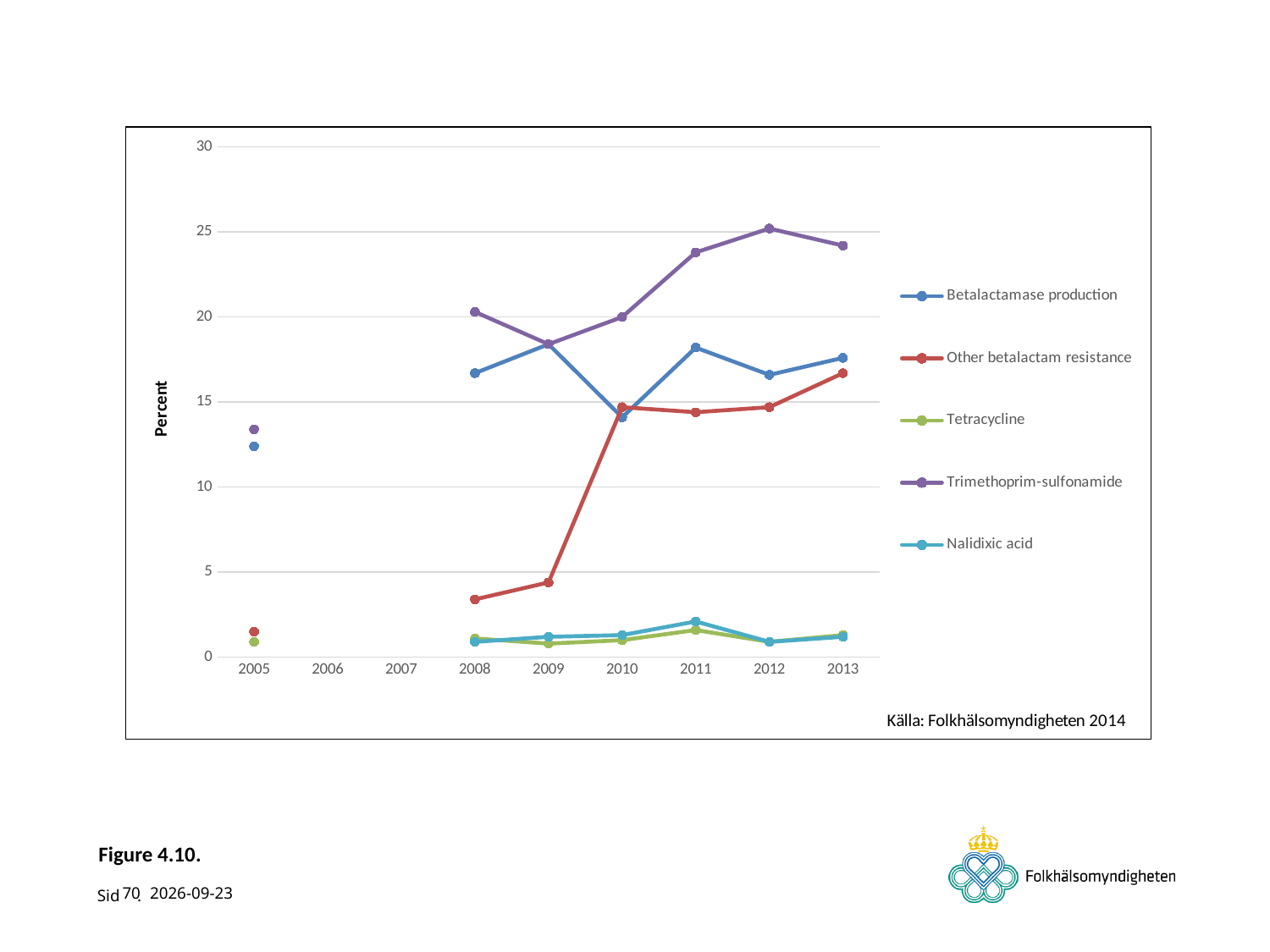
Is the value for Trimethoprim-sulfonamide in 2011 greater or less than 20? greater In which year does Trimethoprim-sulfonamide reach its highest value? 2012 What is the label on the y axis? Percent Which series has the highest value in 2013? Trimethoprim-sulfonamide Is the value for Other betalactam resistance in 2008 greater or less than 5? less What kind of chart is shown on the slide? Line chart How many series does the legend list? 5 In which year is Other betalactam resistance at its lowest? 2005 In 2010, which is higher: Betalactamase production or Trimethoprim-sulfonamide? Trimethoprim-sulfonamide How many years are labelled on the x axis? 9 Does Other betalactam resistance rise or fall from 2008 to 2013? Rise Is the value for Betalactamase production in 2005 greater or less than 10? greater